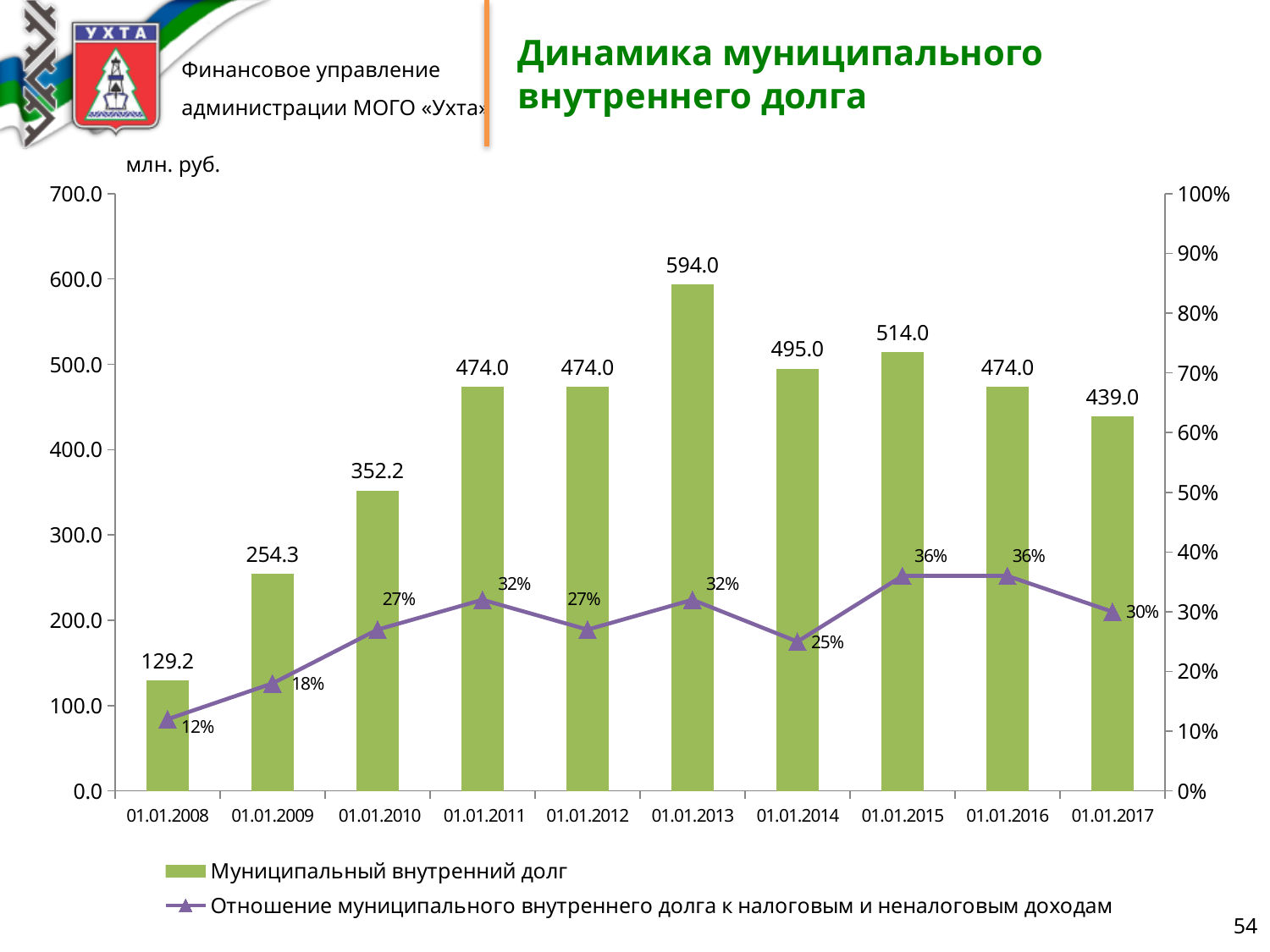
On which date is the municipal internal debt highest? 01.01.2013 What is the difference between the municipal internal debt on 01.01.2013 and on 01.01.2017? 155.0 Which is larger: the municipal internal debt on 01.01.2015 or on 01.01.2016? 01.01.2015 What is the value of the municipal internal debt (Муниципальный внутренний долг) on 01.01.2013? 594.0 How many dates are shown on the x axis of the chart? 10 What kind of chart is used to show the municipal internal debt? bar chart What is the value of the municipal internal debt on 01.01.2008? 129.2 On which date is the municipal internal debt lowest? 01.01.2008 Does the municipal internal debt rise or fall from 01.01.2008 to 01.01.2013? rise What is the ratio of municipal internal debt to tax and non-tax revenues on 01.01.2014? 25% What is the lowest value of the ratio of municipal internal debt to tax and non-tax revenues shown on the chart? 12% How many series does the legend list? 2